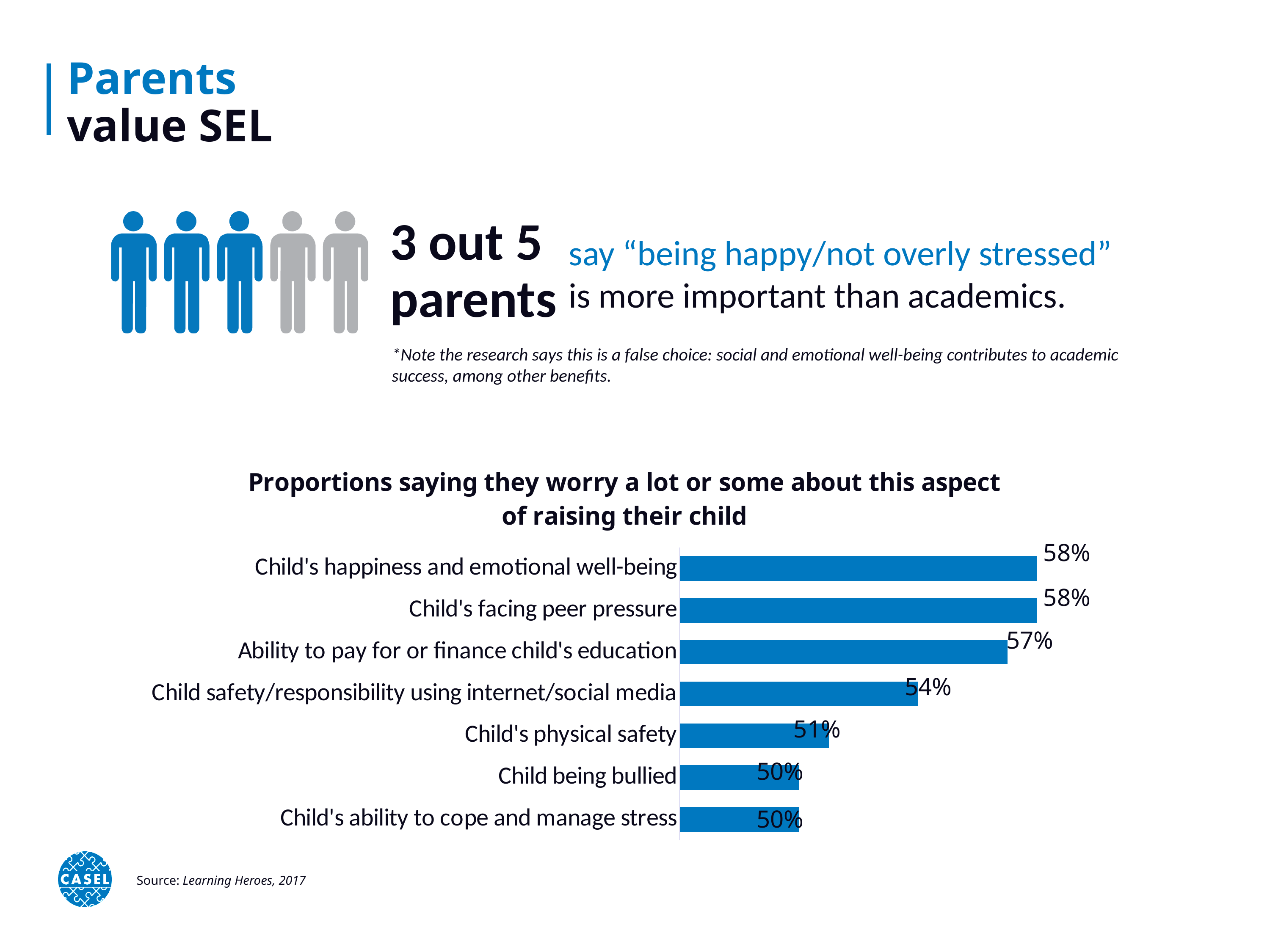
What is the value for 'Child being bullied'? 50% What is the title of the chart? Proportions saying they worry a lot or some about this aspect of raising their child What is the value for 'Child's facing peer pressure'? 58% What is the difference between the value for 'Ability to pay for or finance child's education' and the value for 'Child's physical safety'? 6% Which is larger: the value for 'Child safety/responsibility using internet/social media' or the value for 'Child being bullied'? Child safety/responsibility using internet/social media What is the difference between the value for 'Child's happiness and emotional well-being' and the value for 'Child's ability to cope and manage stress'? 8% How many categories are shown in the bar chart? 7 What source is cited for the chart? Learning Heroes, 2017 What percentage of parents say they worry a lot or some about their child's physical safety? 51% What kind of chart is shown on the slide? Bar chart What is the value for 'Ability to pay for or finance child's education'? 57% What is the value for 'Child safety/responsibility using internet/social media'? 54%